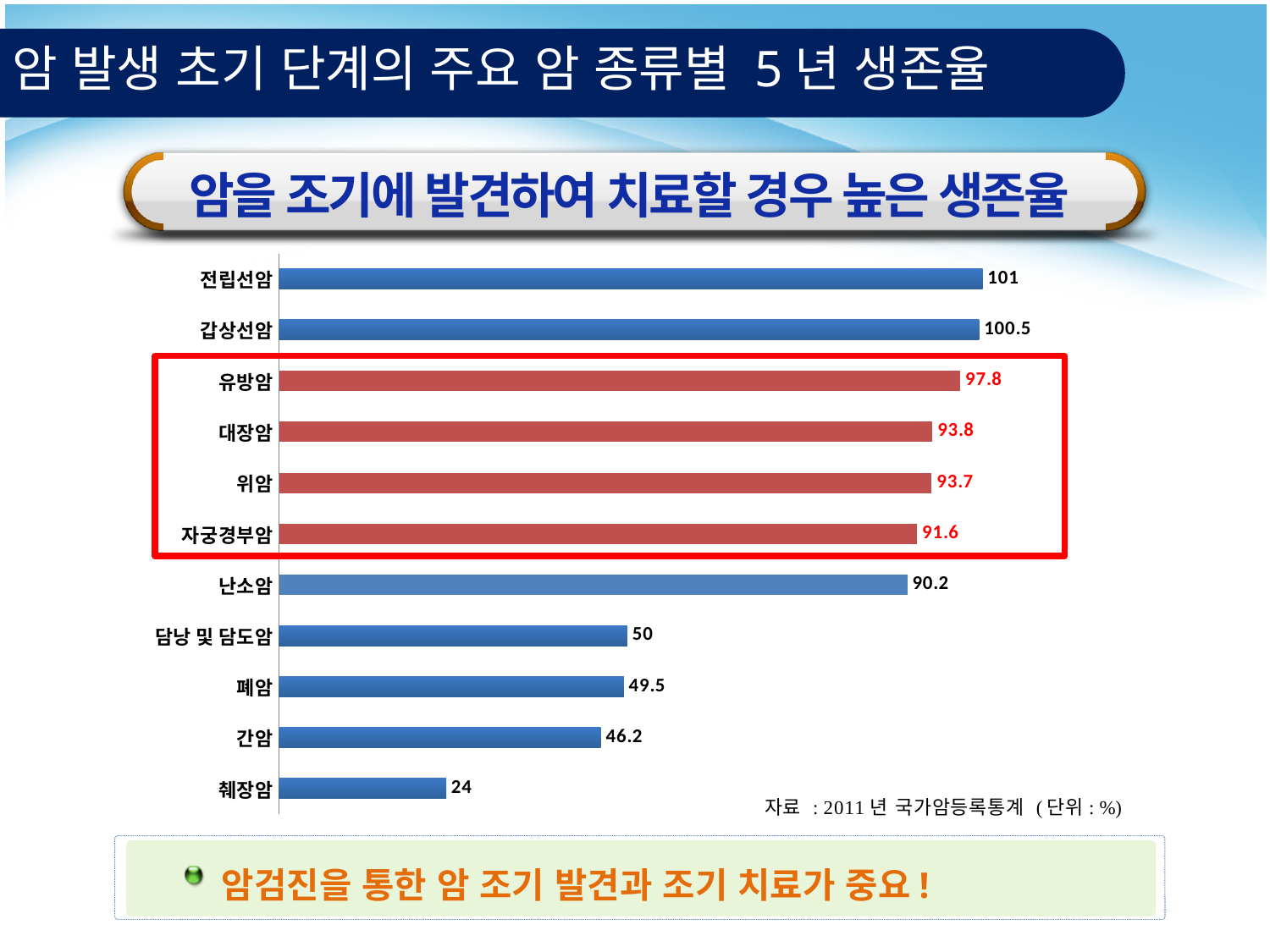
What is the difference between the values for 전립선암 and 췌장암? 77 Which cancer type has the highest value in the chart? 전립선암 Which cancer type has the lowest value in the chart? 췌장암 What is the 5-year survival rate shown for 유방암? 97.8 Which has a larger value, 간암 or 담낭 및 담도암? 담낭 및 담도암 How many bars are coloured red and enclosed in the red box? 4 What value is shown for 췌장암? 24 Which has a larger value, 난소암 or 폐암? 난소암 What is the difference between the values for 유방암 and 자궁경부암? 6.2 What value is shown for 담낭 및 담도암? 50 What kind of chart is shown on the slide? Bar chart How many cancer types are shown in the chart? 11